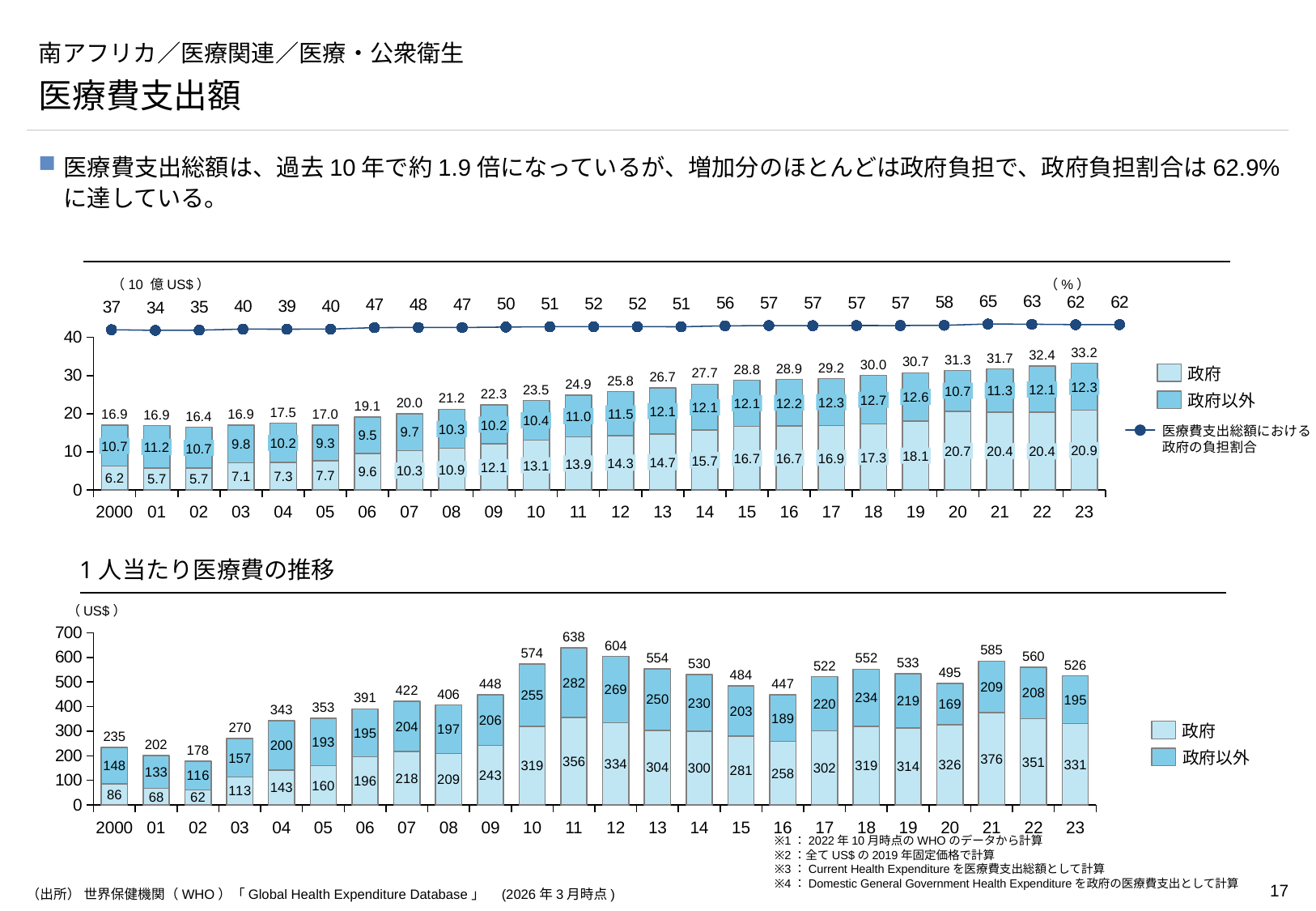
In the top chart, what is the difference between the 政府 value for 23 and the 政府 value for 2000? 14.7 In the top chart, which year has the highest 政府の負担割合? 20 In the bottom chart, which year has the lowest total per-capita health expenditure? 02 In the top chart, which year has the lowest 政府の負担割合? 01 In the top chart, what is the 政府の負担割合 (%) for 23? 62 In the bottom chart (1人当たり医療費の推移), what is the total for 11? 638 In the top chart, what is the 政府 value for 2000? 6.2 In the bottom chart, what is the 政府 value for 21? 376 How many series does the legend of the top chart list? 3 What kind of chart is the bottom chart (1人当たり医療費の推移)? stacked bar chart In the bottom chart, which is larger, the 政府以外 value for 11 or for 12? 11 In the top chart (医療費支出額), what is the total health expenditure for 23? 33.2